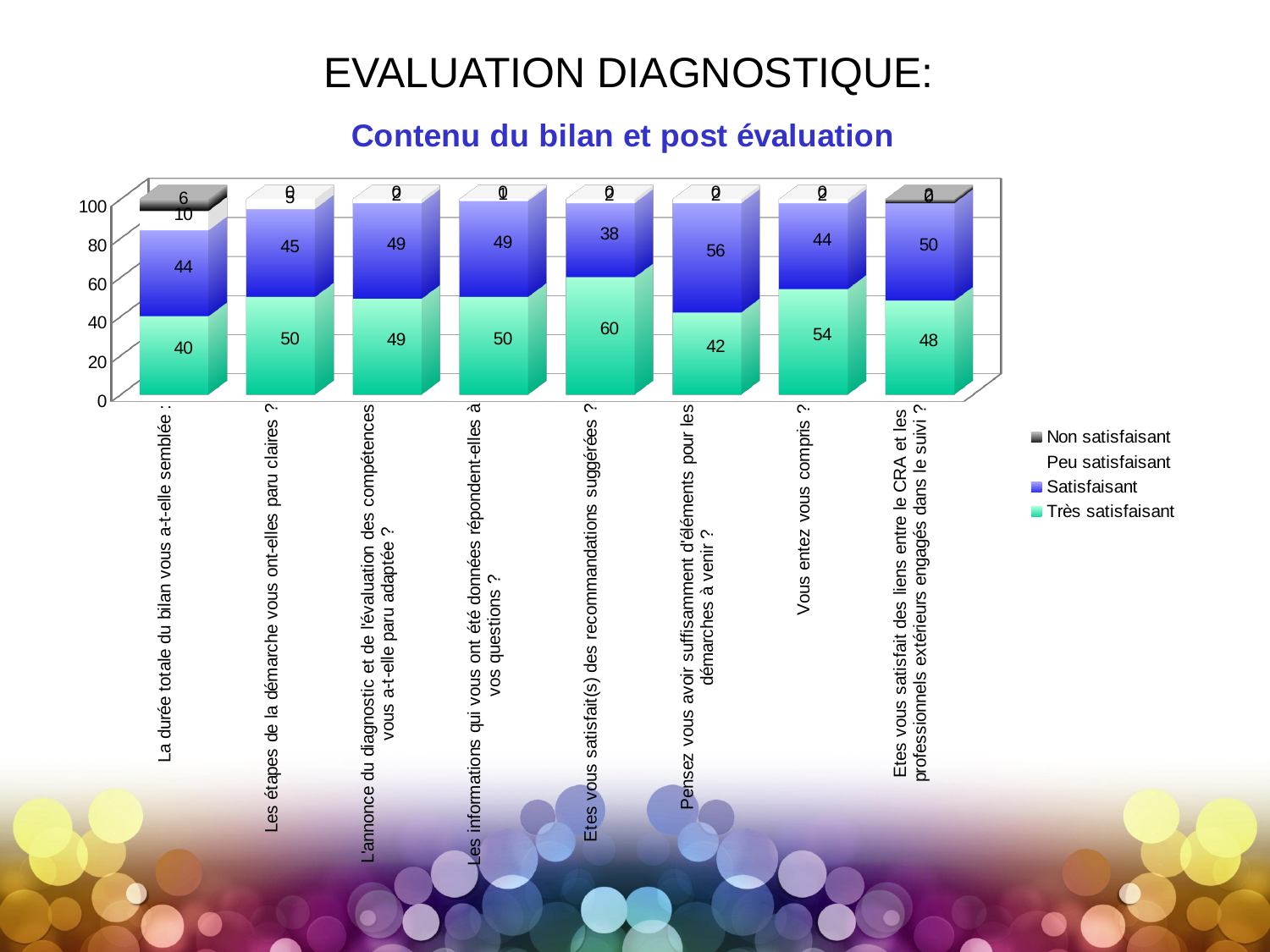
What is the 'Satisfaisant' value for 'Pensez vous avoir suffisamment d'éléments pour les démarches à venir ?' 56 How many series does the legend list? 4 Which is larger: the 'Satisfaisant' value for 'Pensez vous avoir suffisamment d'éléments pour les démarches à venir ?' or for 'Etes vous satisfait(s) des recommandations suggérées ?' Pensez vous avoir suffisamment d'éléments pour les démarches à venir ? What is the 'Très satisfaisant' value for 'Etes vous satisfait(s) des recommandations suggérées ?' 60 What is the 'Non satisfaisant' value for 'La durée totale du bilan vous a-t-elle semblée :'? 6 Which category has the highest 'Très satisfaisant' value? Etes vous satisfait(s) des recommandations suggérées ? What is the 'Très satisfaisant' value for 'La durée totale du bilan vous a-t-elle semblée :'? 40 What kind of chart is shown on the slide? stacked bar chart What is the subtitle of the chart shown in blue text? Contenu du bilan et post évaluation How many categories (questions) are shown on the x axis? 8 Which category has the lowest 'Très satisfaisant' value? La durée totale du bilan vous a-t-elle semblée : What is the difference between the 'Très satisfaisant' values for 'Vous entez vous compris ?' and 'La durée totale du bilan vous a-t-elle semblée :'? 14